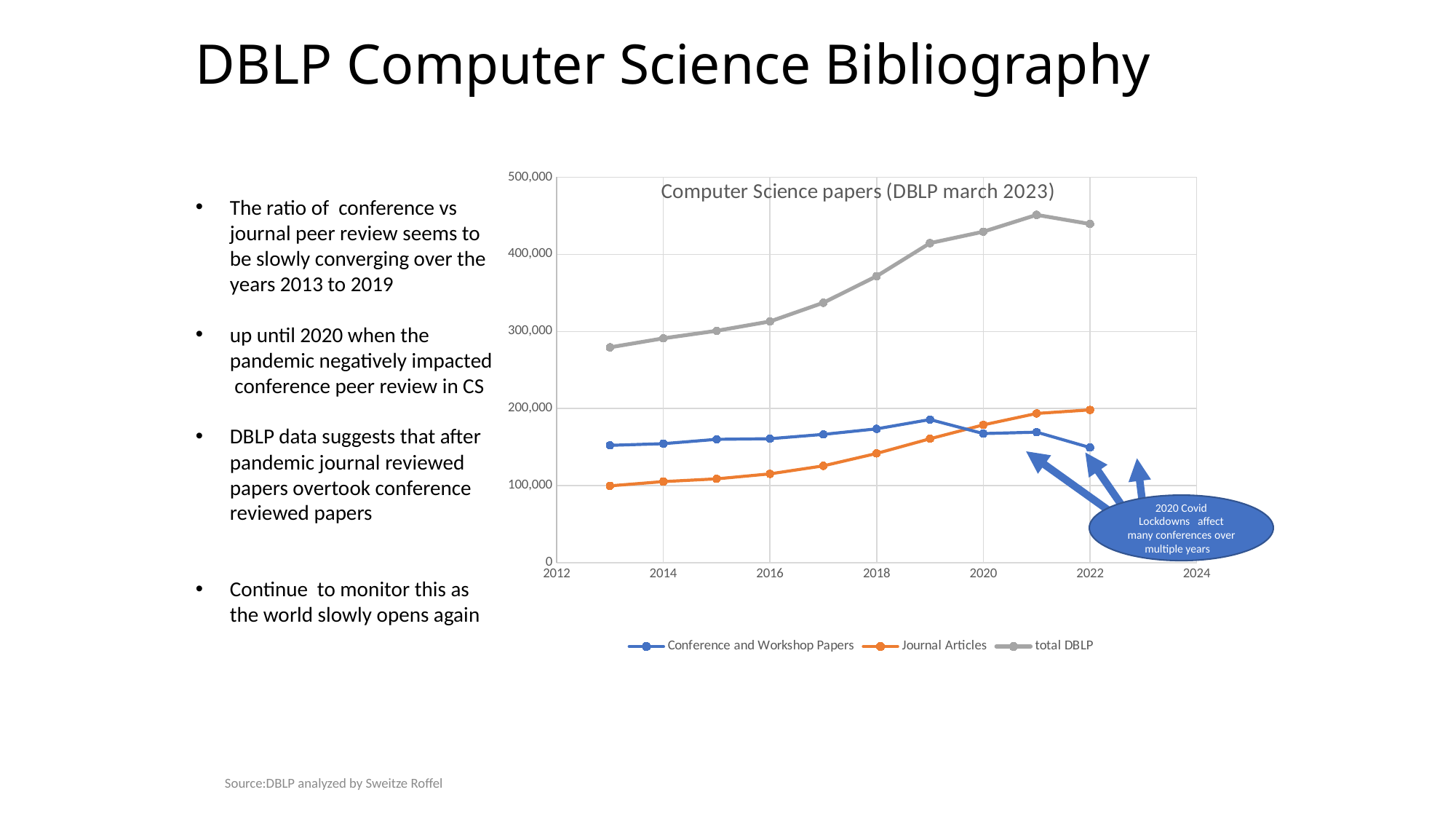
Is the total DBLP value for 2013 greater or less than 300,000? less In which year is the total DBLP value highest? 2021 In which year is the Conference and Workshop Papers value highest? 2019 In which year is the Journal Articles value lowest? 2013 Which series is drawn in grey? total DBLP What is the title of the chart? Computer Science papers (DBLP march 2023) Do the Journal Articles values rise or fall from 2013 to 2022? rise What kind of chart is shown on the slide? Line chart How many data points does the Journal Articles series have? 10 How many series does the chart legend list? 3 In 2022, which is larger: Journal Articles or Conference and Workshop Papers? Journal Articles Is the total DBLP value for 2021 greater or less than 400,000? greater